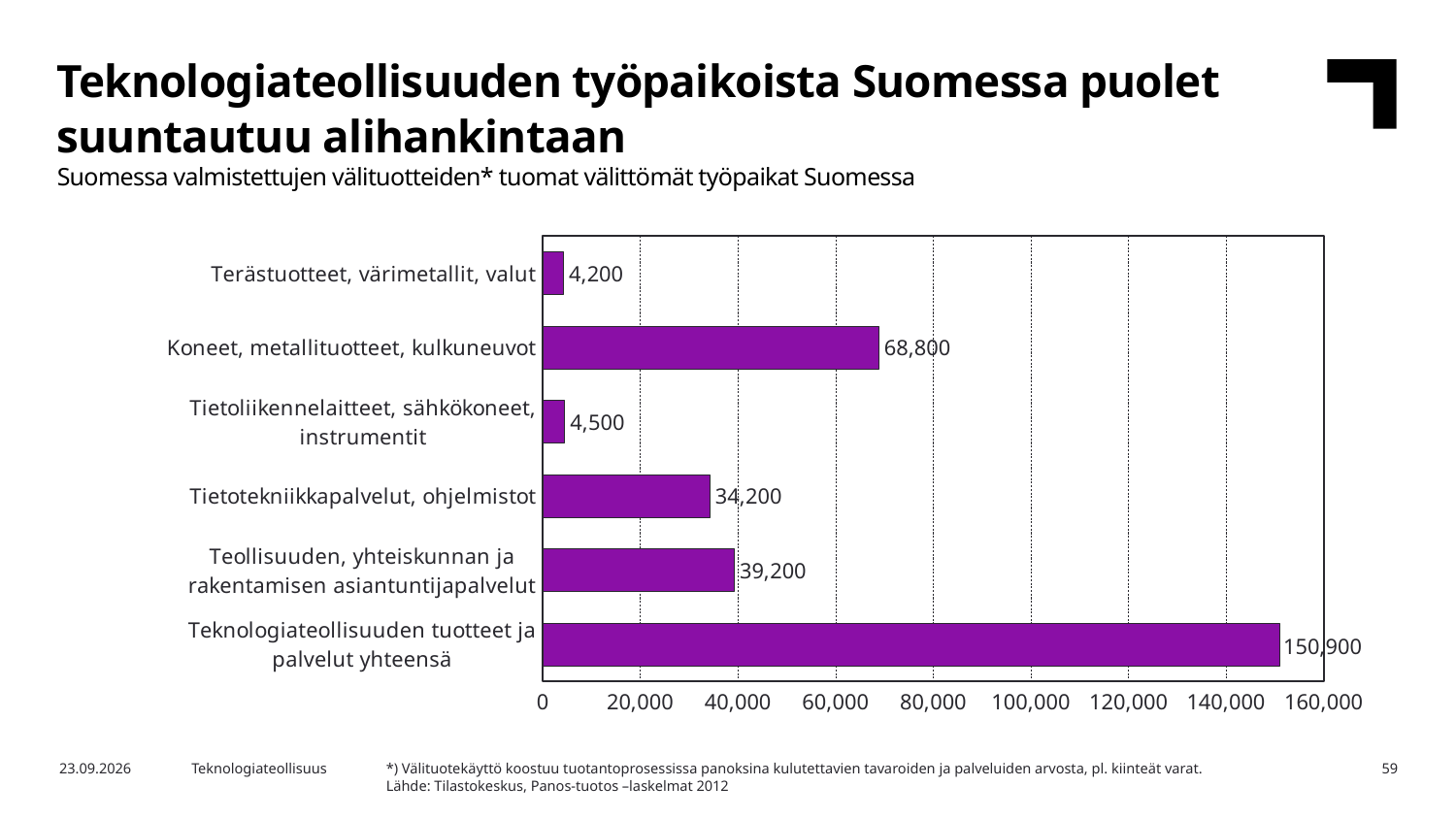
What is the value for Koneet, metallituotteet, kulkuneuvot? 68,800 What kind of chart is shown on the slide? bar chart What is the value for Tietotekniikkapalvelut, ohjelmistot? 34,200 What is the value for Teollisuuden, yhteiskunnan ja rakentamisen asiantuntijapalvelut? 39,200 Which is larger: the value for Tietoliikennelaitteet, sähkökoneet, instrumentit or the value for Terästuotteet, värimetallit, valut? Tietoliikennelaitteet, sähkökoneet, instrumentit What is the subtitle text shown above the chart? Suomessa valmistettujen välituotteiden* tuomat välittömät työpaikat Suomessa What is the difference between the values for Koneet, metallituotteet, kulkuneuvot and Tietotekniikkapalvelut, ohjelmistot? 34,600 Which category has the highest value? Teknologiateollisuuden tuotteet ja palvelut yhteensä Which category has the lowest value? Terästuotteet, värimetallit, valut How many categories are shown in the chart? 6 What is the value for Teknologiateollisuuden tuotteet ja palvelut yhteensä? 150,900 Is the value for Teollisuuden, yhteiskunnan ja rakentamisen asiantuntijapalvelut greater or less than 40,000? less